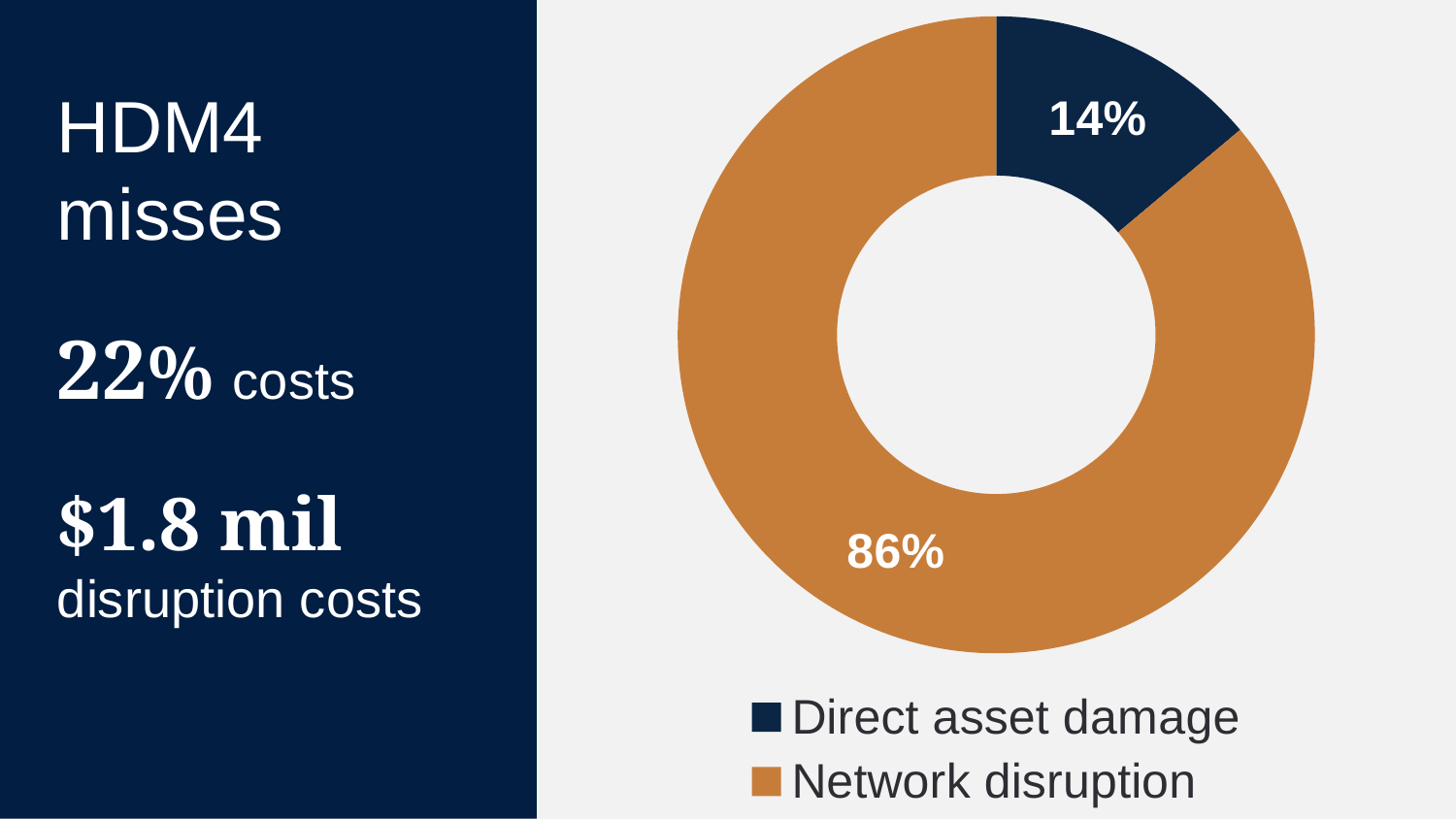
What kind of chart is shown on the slide? Doughnut chart How many categories does the chart show? 2 What share of the chart is Direct asset damage? 14% What is the total of the two slices shown on the chart? 100% What is the difference in percentage points between Network disruption and Direct asset damage? 72 What colour is the Network disruption slice? Orange-brown Which category has the largest share of the chart? Network disruption What share of the chart is Network disruption? 86% What colour is the Direct asset damage slice? Dark navy blue Which category has the smallest share of the chart? Direct asset damage Which is larger, Direct asset damage or Network disruption? Network disruption Is the share for Direct asset damage greater or less than 50%? less